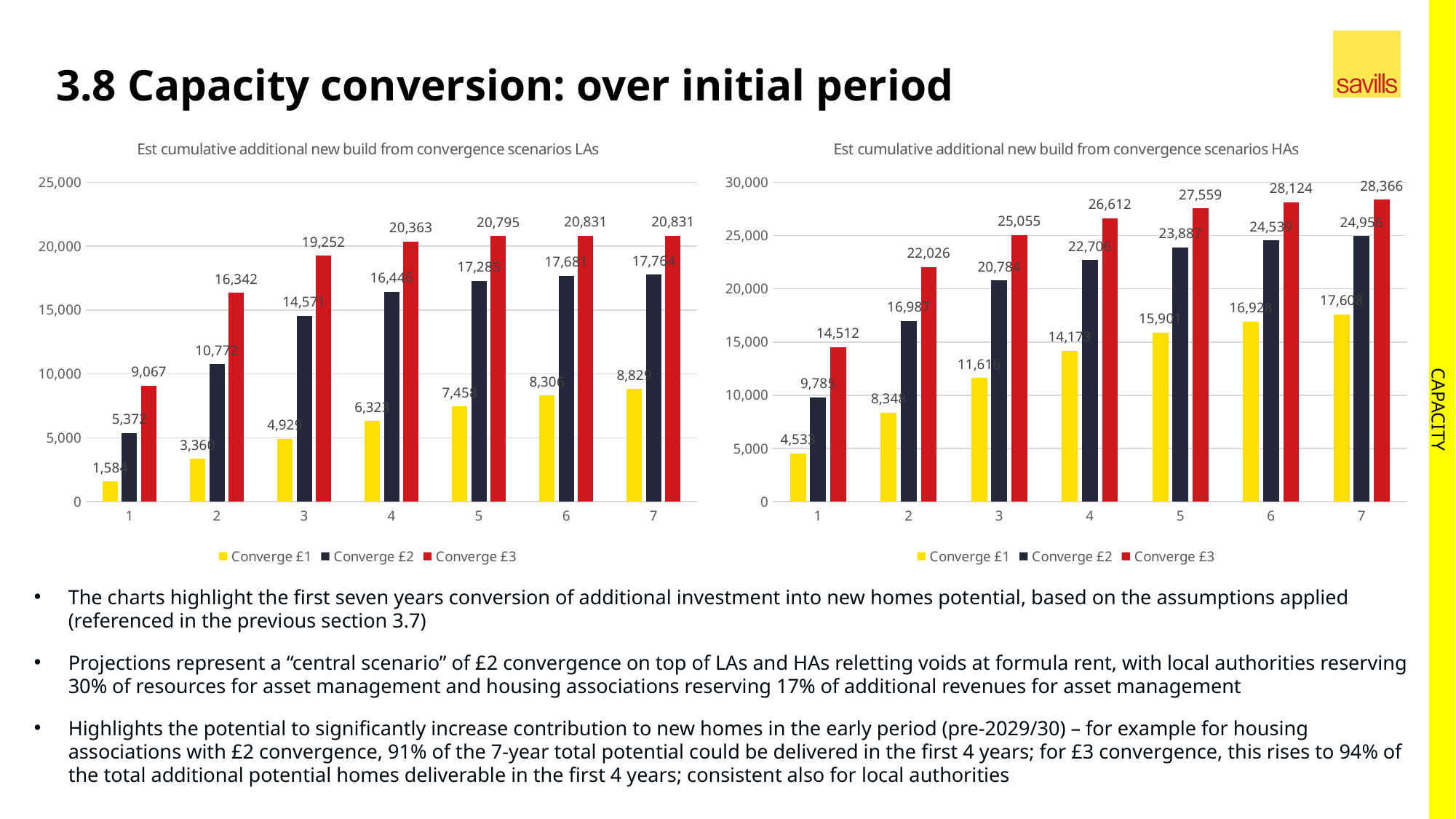
In the left chart (LAs), which is larger in year 1: Converge £2 or Converge £3? Converge £3 In the chart titled 'Est cumulative additional new build from convergence scenarios HAs', what is the value for Converge £3 in year 7? 28,366 In the right chart (HAs), what is the value for Converge £2 in year 1? 9,785 How many series does the legend of the left chart (LAs) list? 3 How many years are shown on the x axis of the right chart (HAs)? 7 In the left chart (LAs), is the value for Converge £1 in year 7 greater or less than 10,000? less In the chart titled 'Est cumulative additional new build from convergence scenarios LAs', what is the value for Converge £3 in year 1? 9,067 In the right chart (HAs), which year has the highest Converge £3 value? 7 In the left chart (LAs), what is the value for Converge £1 in year 1? 1,584 In the right chart (HAs), what is the difference between the Converge £3 values for year 7 and year 6? 242 What kind of chart is the left chart (LAs)? bar chart In the left chart (LAs), what is the difference between the Converge £3 values for year 2 and year 1? 7,275